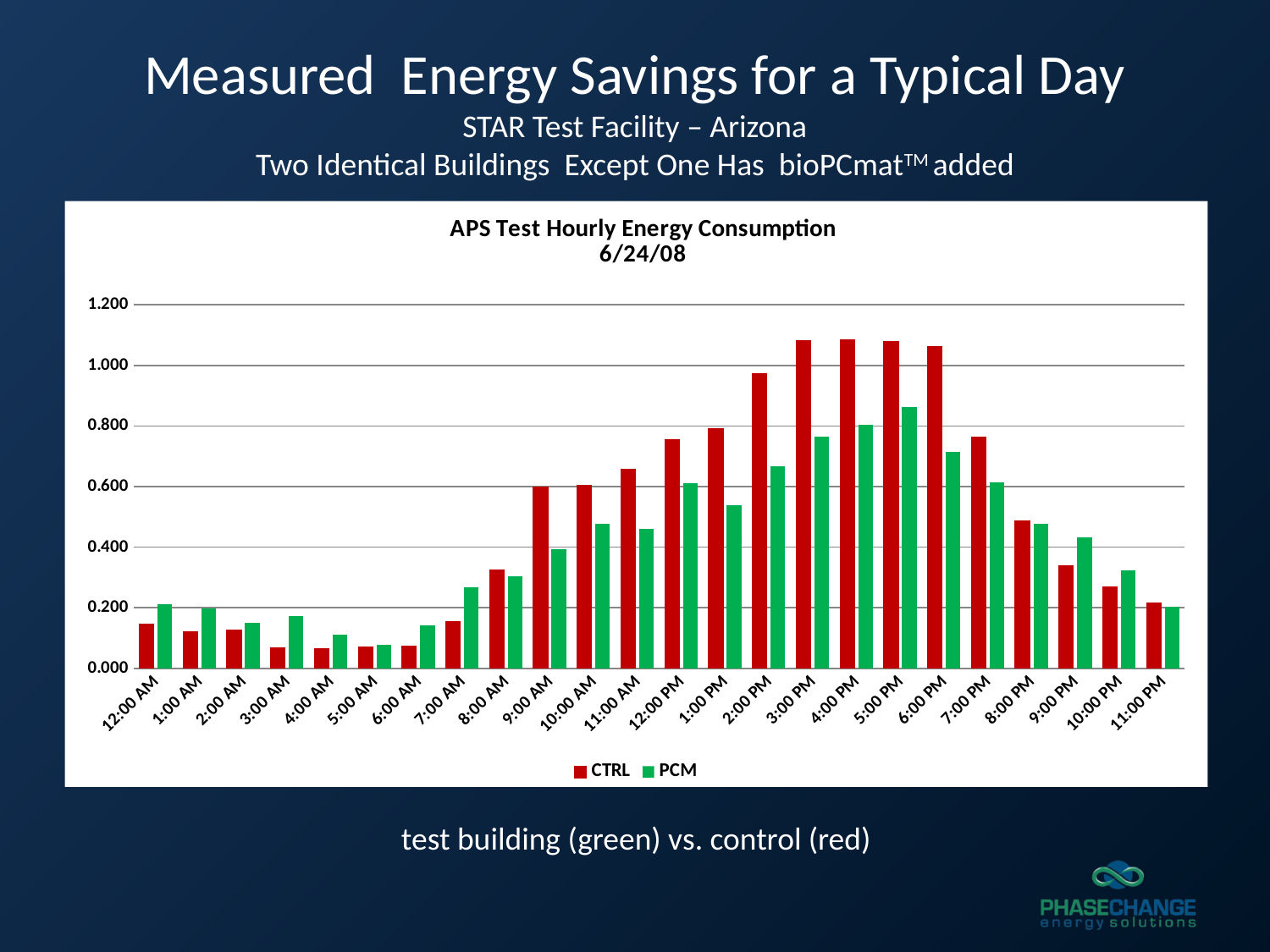
Is the PCM value at 1:00 PM greater or less than 0.600? less Do the CTRL values rise or fall from 5:00 PM to 11:00 PM? fall How many hourly categories are plotted along the x axis? 24 At which hour is the PCM value lowest? 5:00 AM At which hour is the PCM value highest? 5:00 PM At 3:00 PM, which series has the larger value, CTRL or PCM? CTRL What date is shown in the chart title? 6/24/08 Is the CTRL value at 2:00 PM greater or less than 0.800? greater How many series does the chart legend list? 2 At 12:00 AM, which series has the larger value, CTRL or PCM? PCM Is the CTRL value at 6:00 PM greater or less than 1.000? greater What kind of chart is shown on the slide? bar chart